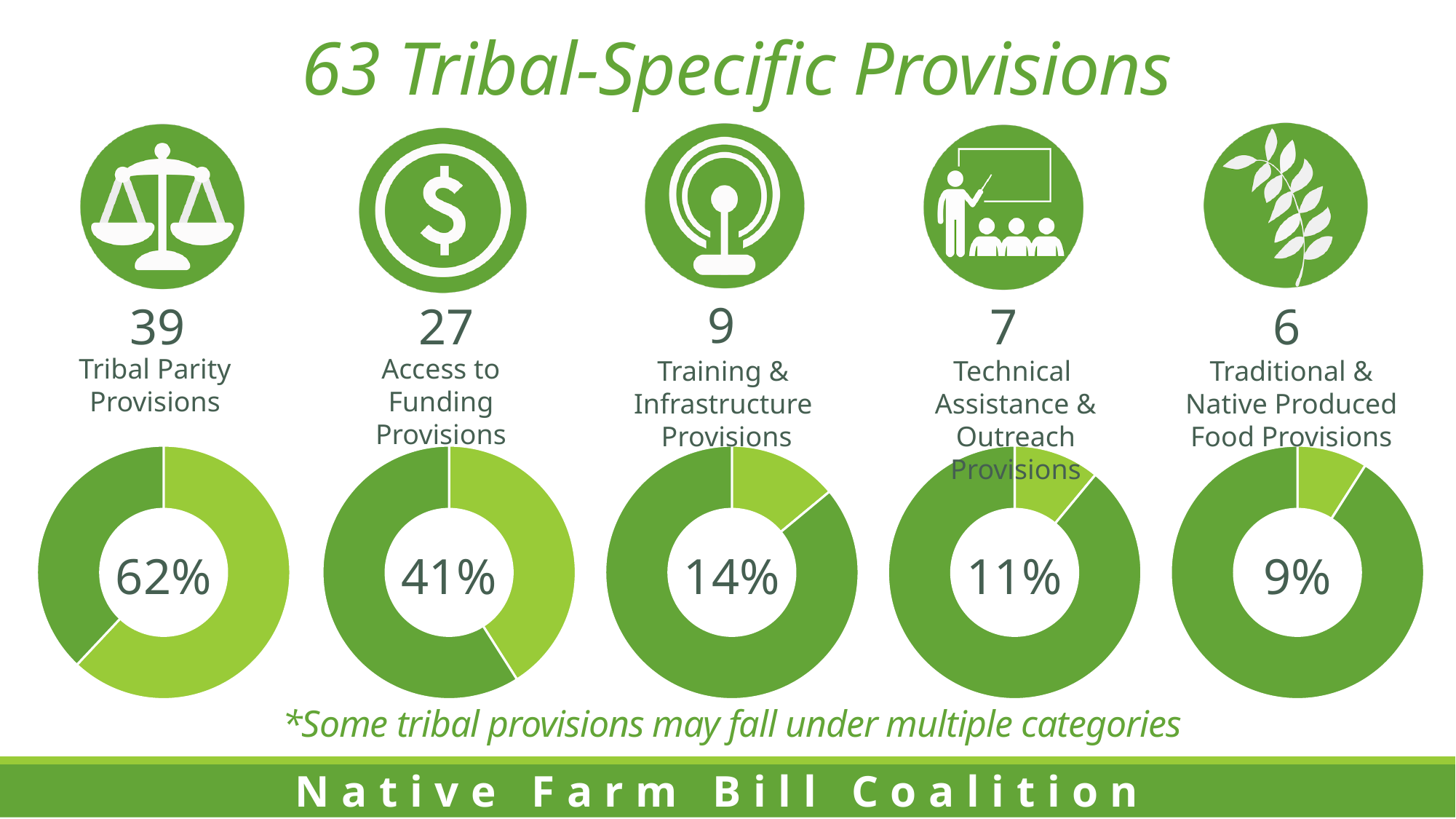
How many donut charts are shown on the slide? 5 What percentage is shown in the Access to Funding Provisions donut chart? 41% Which category has the lowest percentage among the five donut charts? Traditional & Native Produced Food Provisions Which is larger: the percentage for Training & Infrastructure Provisions or for Technical Assistance & Outreach Provisions? Training & Infrastructure Provisions What percentage is shown in the Training & Infrastructure Provisions donut chart? 14% What percentage is shown in the Traditional & Native Produced Food Provisions donut chart? 9% Which category has the highest percentage among the five donut charts? Tribal Parity Provisions What percentage is shown in the Technical Assistance & Outreach Provisions donut chart? 11% What percentage is shown in the centre of the Tribal Parity Provisions donut chart? 62% What kind of chart is used to show each category's percentage on the slide? Donut chart How many Access to Funding Provisions are listed above its donut chart? 27 What is the difference in percentage points between the Tribal Parity Provisions chart and the Access to Funding Provisions chart? 21